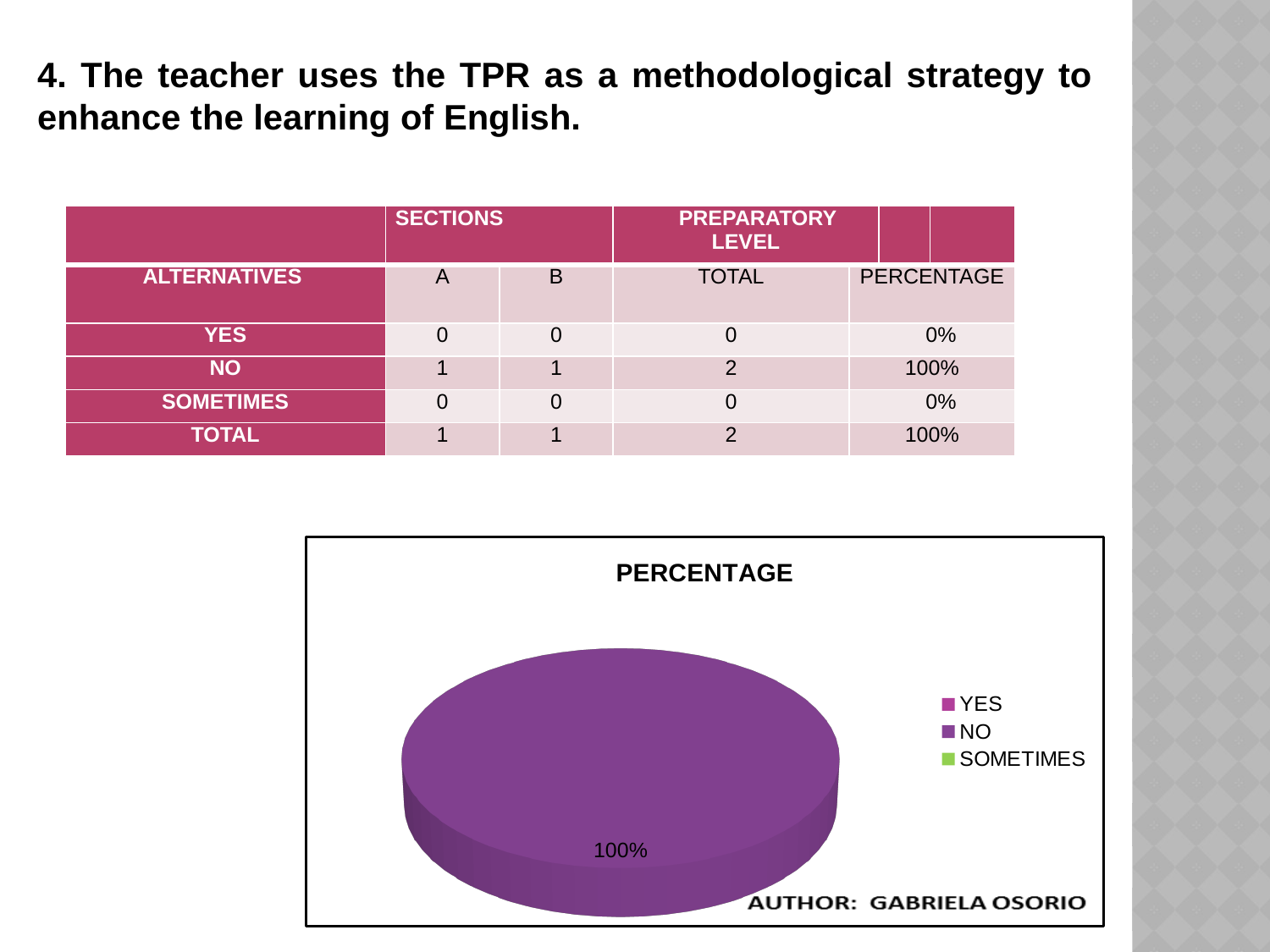
What is the percentage for YES according to the slide? 0% Which alternative does the single visible slice of the pie chart represent? NO What percentage is printed on the pie chart's slice? 100% What share of the pie does the NO slice take up? 100% Which legend entries are listed in the chart, in order? YES, NO, SOMETIMES What kind of chart is shown on the slide? pie chart What is the percentage for SOMETIMES according to the slide? 0% What is the difference between the percentage for NO and the percentage for SOMETIMES? 100% Which is larger in the chart, the share for NO or the share for YES? NO How many entries does the chart's legend list? 3 What is the title of the chart? PERCENTAGE Is the share for NO greater or less than 50%? greater